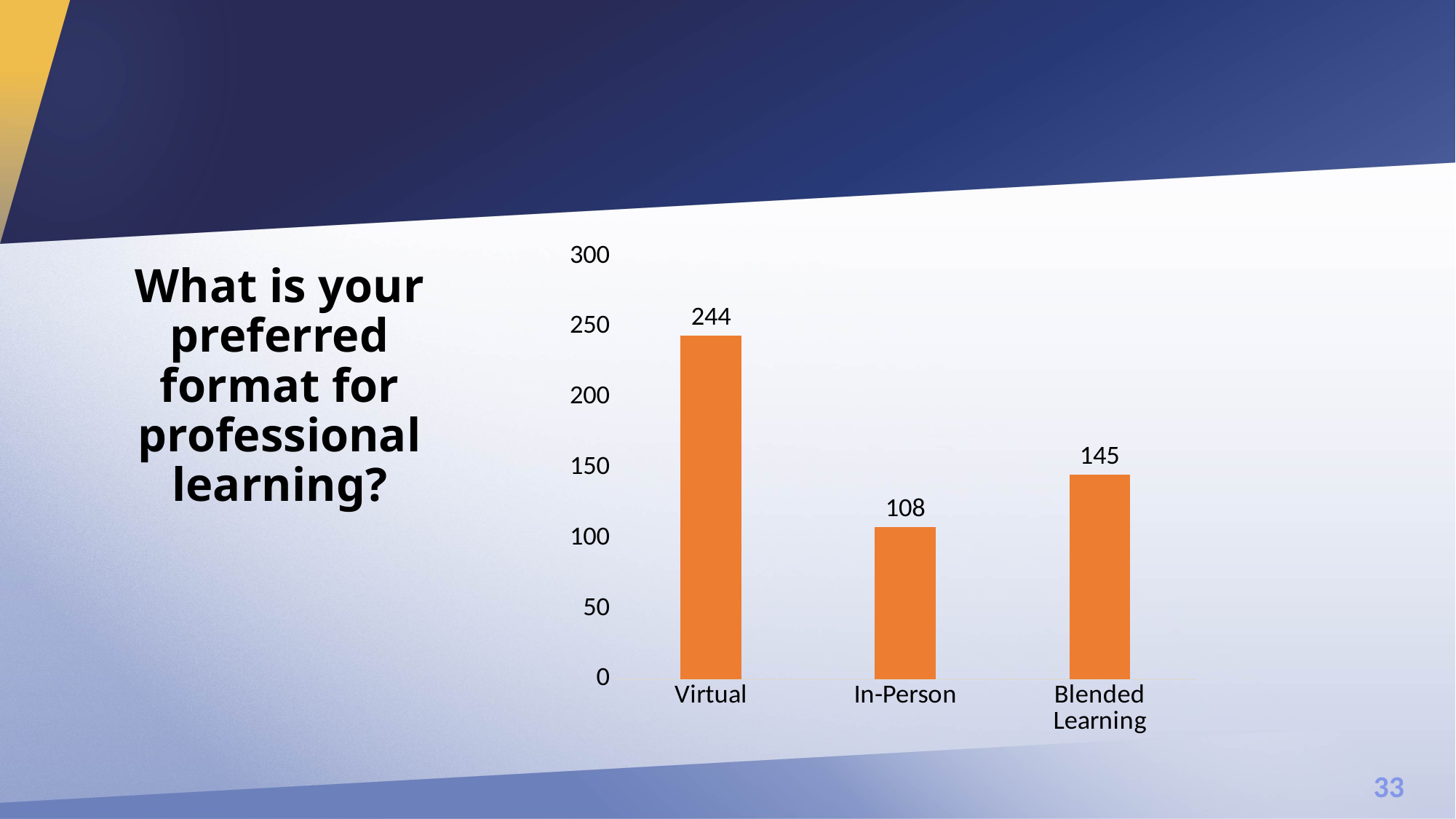
What question does the chart on the slide answer? What is your preferred format for professional learning? What kind of chart is shown on the slide? Bar chart Which format has the lowest value? In-Person Which format has the highest value? Virtual What is the value for Virtual? 244 What is the difference between the values for Blended Learning and In-Person? 37 How many categories are shown on the chart? 3 What is the value for In-Person? 108 What is the difference between the values for Virtual and In-Person? 136 What is the value for Blended Learning? 145 Is the value for Virtual greater or less than 200? greater Which is larger, the value for Blended Learning or the value for In-Person? Blended Learning